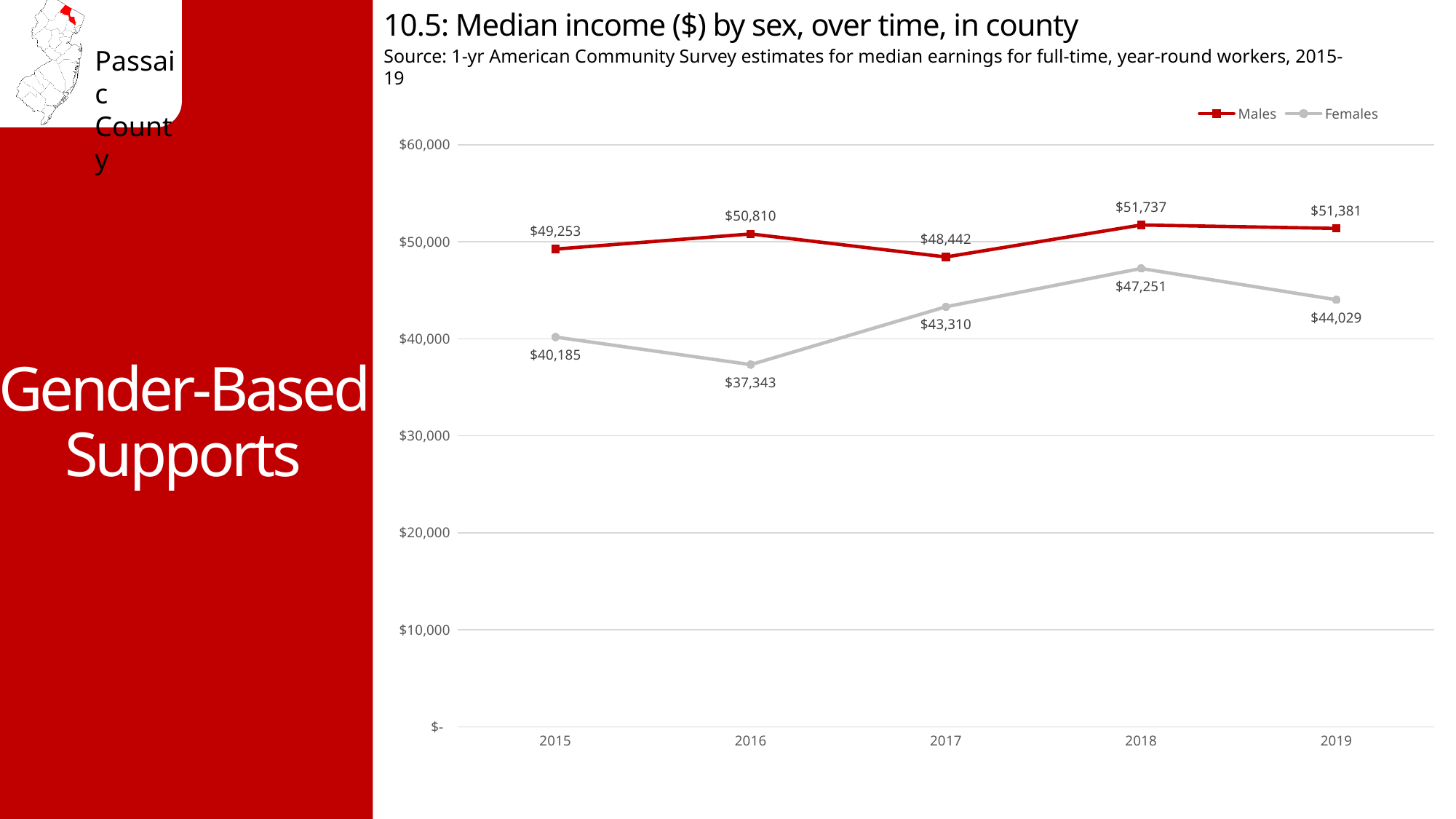
What was the median income for Males in 2016? $50,810 How many series does the legend list? 2 Is the median income for Females in 2016 greater or less than $40,000? less Which was larger in 2017, the median income for Males or for Females? Males How many years are shown on the x axis? 5 What was the median income for Females in 2015? $40,185 Did the median income for Females rise or fall from 2016 to 2018? rise What kind of chart is shown on the slide? line chart What is the difference between the Males and Females median income in 2019? $7,352 What was the median income for Females in 2018? $47,251 In which year was the median income for Females lowest? 2016 In which year was the median income for Males highest? 2018